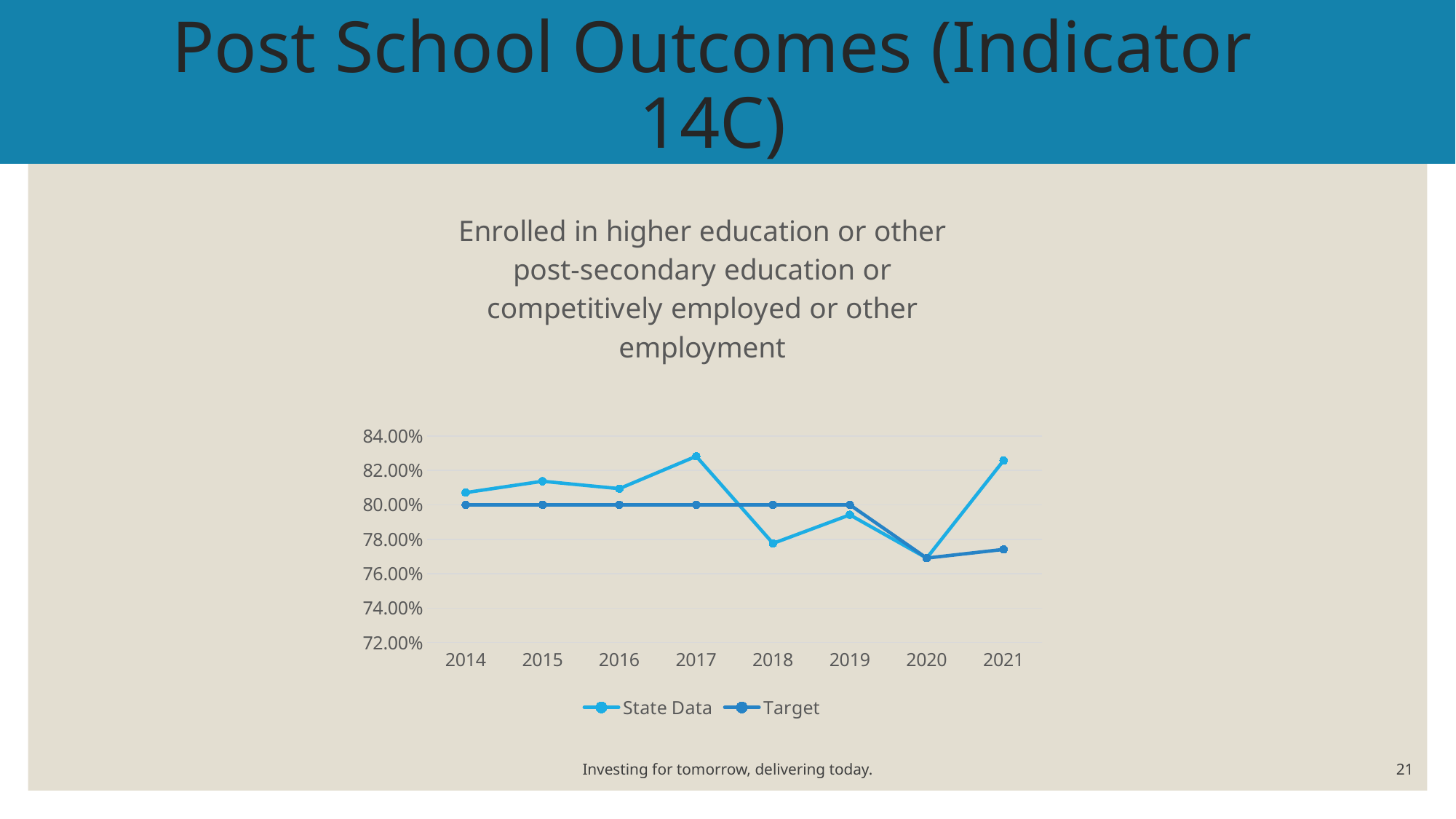
How many years are shown on the x axis? 8 What is the Target value in 2016? 80.00% Does the State Data line rise or fall from 2017 to 2018? fall What are the two series named in the legend? State Data and Target Is the State Data value for 2020 greater or less than 78.00%? less In which year is the State Data value lowest? 2020 Is the State Data value for 2018 greater or less than 80.00%? less In 2014, which series has the higher value, State Data or Target? State Data What kind of chart is shown on the slide? line chart How many series does the legend list? 2 Is the State Data value for 2017 greater or less than 82.00%? greater Which is larger, the State Data value in 2017 or in 2018? 2017